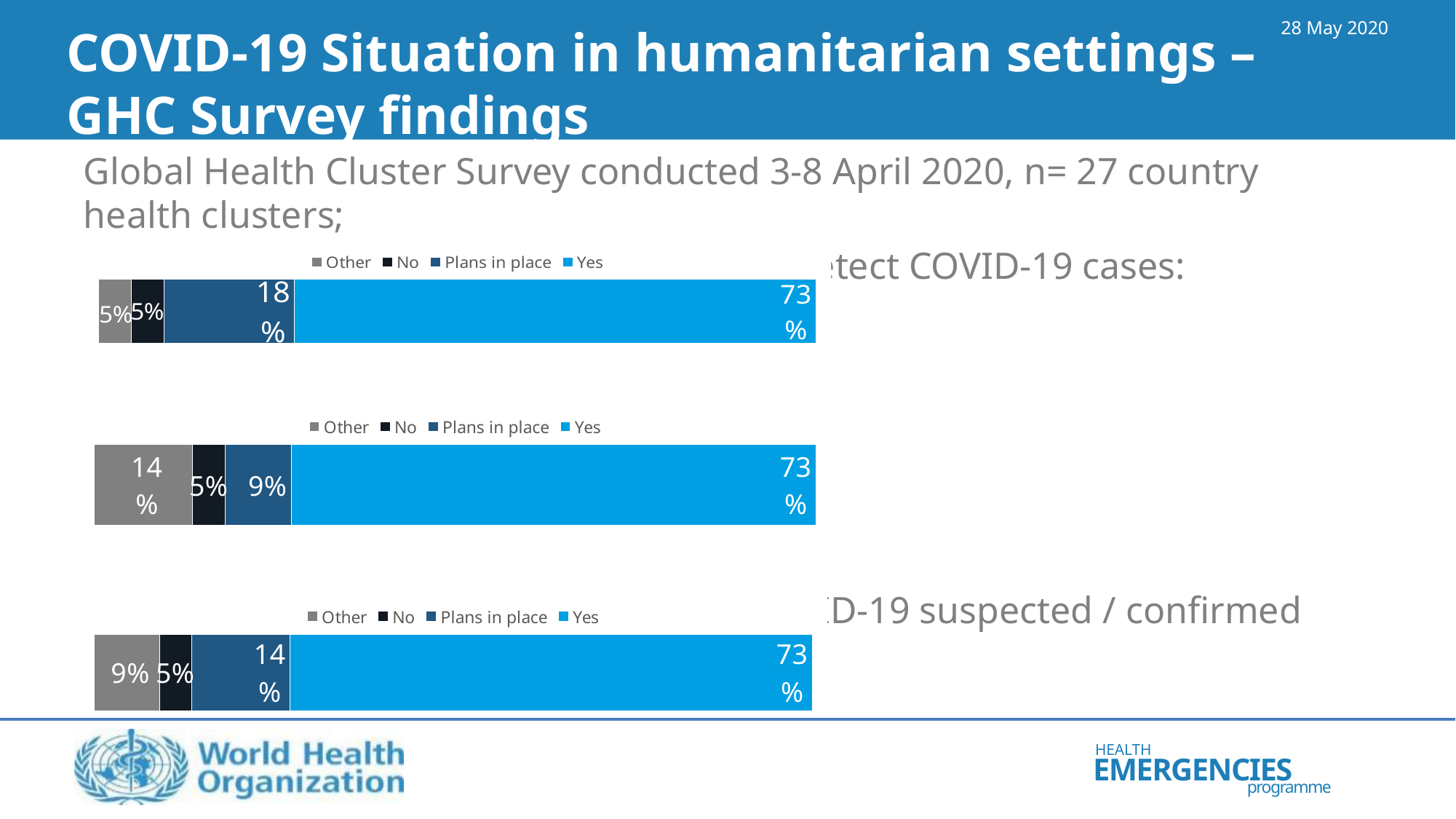
In the middle chart, which series has the smallest share of the bar? No In the top chart, what is the difference between the Yes value and the Plans in place value? 55% In the bottom chart, which series has the largest share of the bar? Yes In the top chart, what is the value for Plans in place? 18% What type of chart is the bottom chart? Stacked bar chart How many series does the legend of the top chart list? 4 In the bottom chart, what is the value for Other? 9% In the middle chart, what is the value for Other? 14% In the top chart, what is the value for Yes? 73% In the bottom chart, what is the value for Plans in place? 14% In the middle chart, which is larger, Other or Plans in place? Other In the middle chart, what is the value for Plans in place? 9%